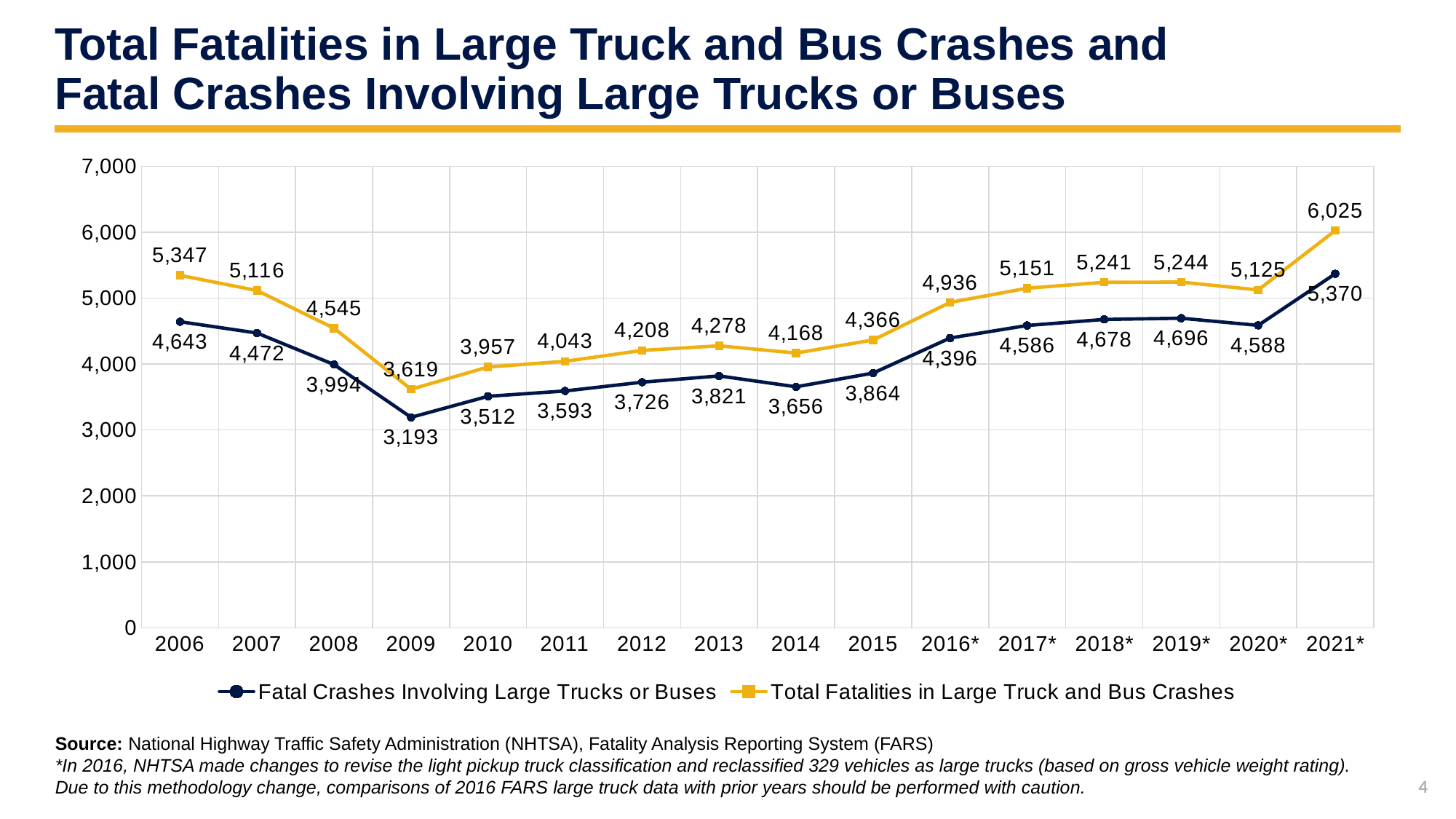
What is the difference between Total Fatalities and Fatal Crashes in 2021*? 655 What colour is the line for Total Fatalities in Large Truck and Bus Crashes? Yellow/gold What type of chart is shown on the slide? Line chart Is the value for Total Fatalities in Large Truck and Bus Crashes in 2021* greater or less than 6,000? greater How many years are plotted along the x axis? 16 What was the value for Fatal Crashes Involving Large Trucks or Buses in 2021*? 5,370 How many series does the legend list? 2 In which year was Fatal Crashes Involving Large Trucks or Buses lowest? 2009 In which year was Total Fatalities in Large Truck and Bus Crashes highest? 2021* Which is larger: Fatal Crashes Involving Large Trucks or Buses in 2006 or in 2019*? 2019* Did Total Fatalities in Large Truck and Bus Crashes rise or fall from 2006 to 2009? Fall What was the value for Total Fatalities in Large Truck and Bus Crashes in 2009? 3,619